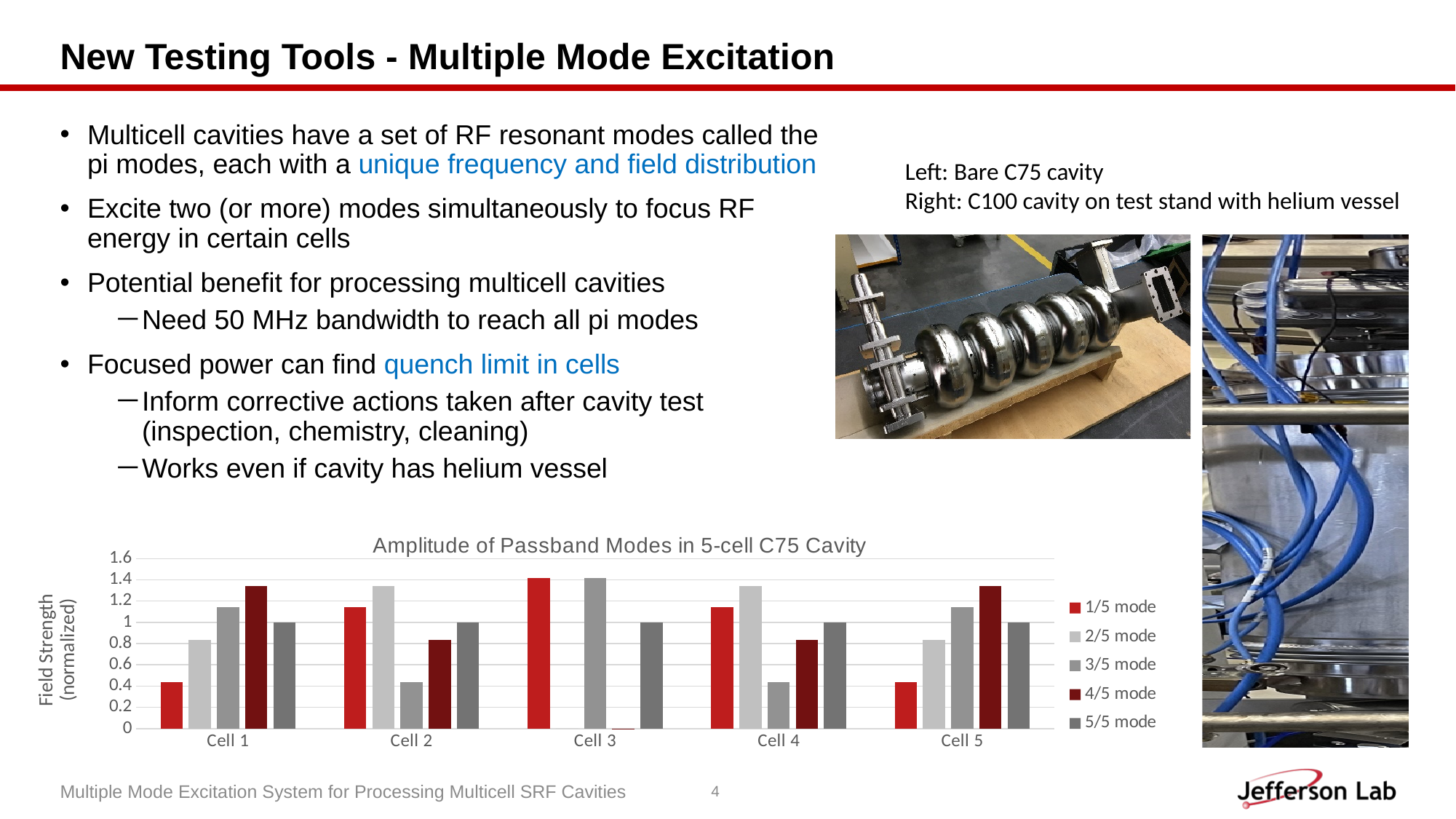
What kind of chart is shown on the slide? bar chart Is the value of the 1/5 mode in Cell 1 greater or less than 0.6? less Is the value of the 3/5 mode in Cell 2 greater or less than 0.6? less Which mode has the lowest value in Cell 5? 1/5 mode How many cells (categories) are shown on the x axis of the chart? 5 In Cell 4, which is larger: the 2/5 mode or the 4/5 mode? 2/5 mode Is the value of the 1/5 mode in Cell 3 greater or less than 1.2? greater What is the value of the 5/5 mode in Cell 3? 1 Which mode has the highest value in Cell 1? 4/5 mode What is the title of the chart? Amplitude of Passband Modes in 5-cell C75 Cavity What is the value of the 5/5 mode in Cell 1? 1 How many series does the chart legend list? 5